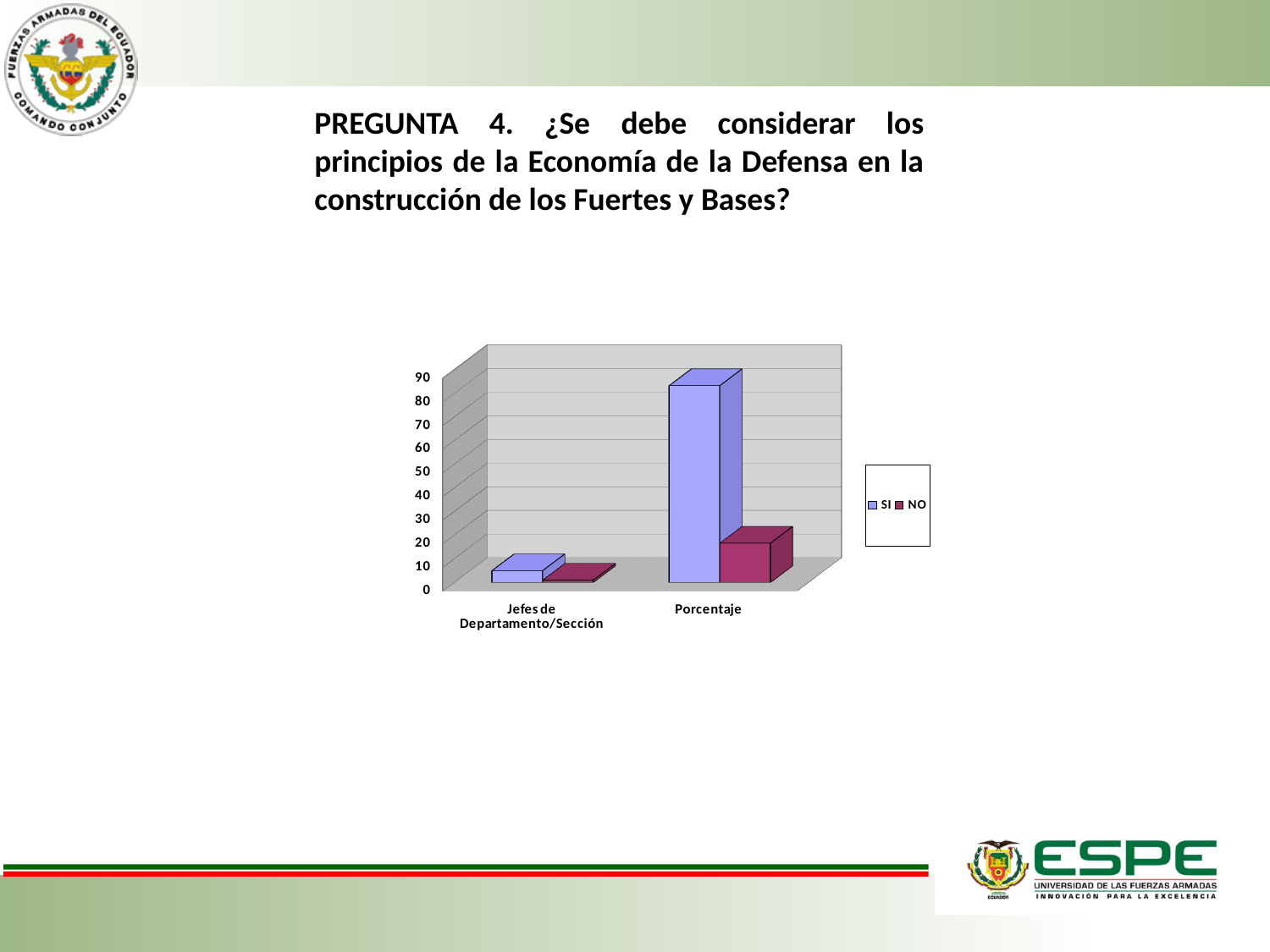
Which category and series has the shortest bar in the chart? NO for Jefes de Departamento/Sección How many categories are shown on the x axis of the chart? 2 Is the SI value for Jefes de Departamento/Sección greater or less than 20? less Which category and series has the tallest bar in the chart? SI for Porcentaje Is the SI value for Porcentaje greater or less than 70? greater For the Jefes de Departamento/Sección category, which is larger, SI or NO? SI What are the two series named in the chart legend? SI and NO Is the NO value for Porcentaje greater or less than 30? less How many series does the chart legend list? 2 For the Porcentaje category, which is larger, SI or NO? SI What colour are the bars for the SI series in the chart? light blue/purple What kind of chart is shown on the slide? bar chart